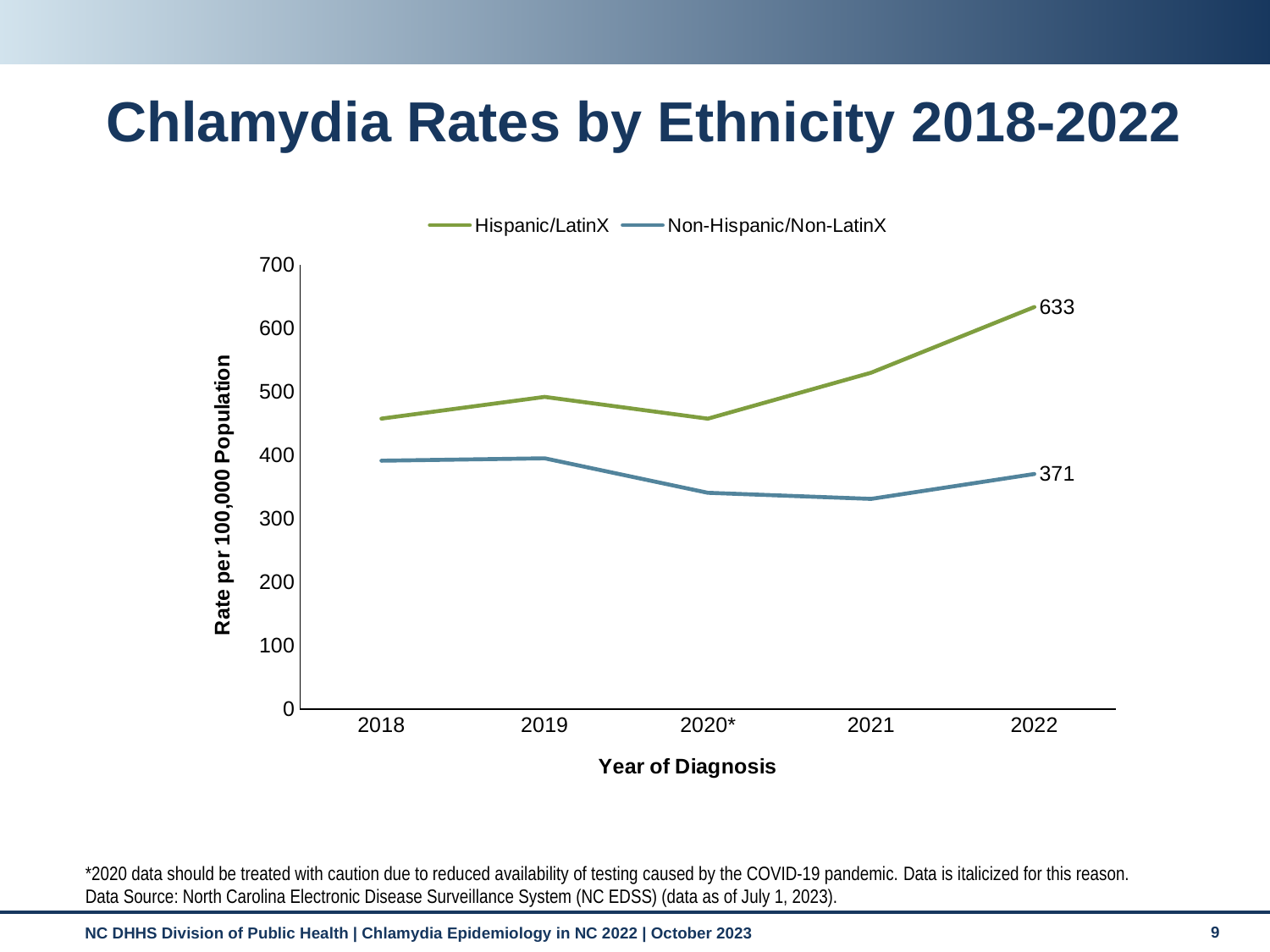
Is the Hispanic/LatinX rate in 2021 greater or less than 500? greater In which year is the Non-Hispanic/Non-LatinX rate lowest? 2021 What is the difference between the Hispanic/LatinX and Non-Hispanic/Non-LatinX rates in 2022? 262 In which year is the Hispanic/LatinX rate highest? 2022 Is the Non-Hispanic/Non-LatinX rate in 2021 greater or less than 400? less How many series does the legend list? 2 What kind of chart is shown on the slide? Line chart Which series has the higher rate in 2022, Hispanic/LatinX or Non-Hispanic/Non-LatinX? Hispanic/LatinX What is the chlamydia rate for Hispanic/LatinX in 2022? 633 How many years are shown on the x axis? 5 What is the chlamydia rate for Non-Hispanic/Non-LatinX in 2022? 371 Is the Hispanic/LatinX rate in 2018 greater or less than 400? greater